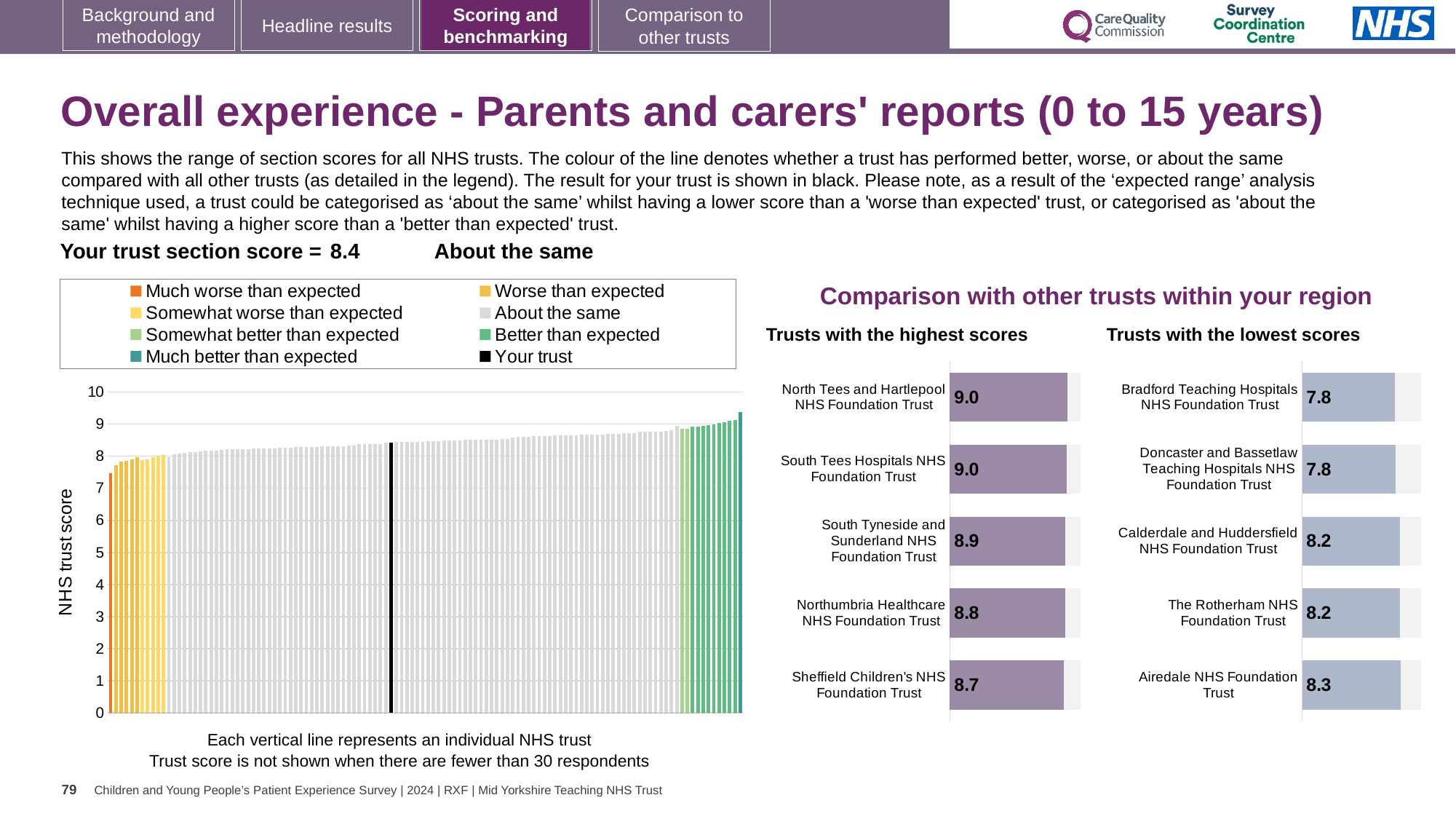
In the main 'NHS trust score' chart on the left, is the value of the black bar (your trust) greater or less than 8? greater In the 'Trusts with the lowest scores' chart, what is the difference between the score for Airedale NHS Foundation Trust and the score for Bradford Teaching Hospitals NHS Foundation Trust? 0.5 In the 'Trusts with the highest scores' chart, what is the score for Sheffield Children's NHS Foundation Trust? 8.7 In the 'Trusts with the lowest scores' chart, what is the score for Bradford Teaching Hospitals NHS Foundation Trust? 7.8 In the 'Trusts with the lowest scores' chart, what is the score for Airedale NHS Foundation Trust? 8.3 How many entries does the legend of the main 'NHS trust score' chart on the left list? 8 In the 'Trusts with the highest scores' chart, which trust has the lowest score? Sheffield Children's NHS Foundation Trust In the 'Trusts with the highest scores' chart, what is the difference between the score for North Tees and Hartlepool NHS Foundation Trust and the score for Sheffield Children's NHS Foundation Trust? 0.3 In the 'Trusts with the highest scores' chart, what is the score for Northumbria Healthcare NHS Foundation Trust? 8.8 In the 'Trusts with the lowest scores' chart, which has the larger score: Calderdale and Huddersfield NHS Foundation Trust or Bradford Teaching Hospitals NHS Foundation Trust? Calderdale and Huddersfield NHS Foundation Trust How many trusts are shown in the 'Trusts with the highest scores' chart? 5 In the 'Trusts with the lowest scores' chart, which trust has the highest score? Airedale NHS Foundation Trust